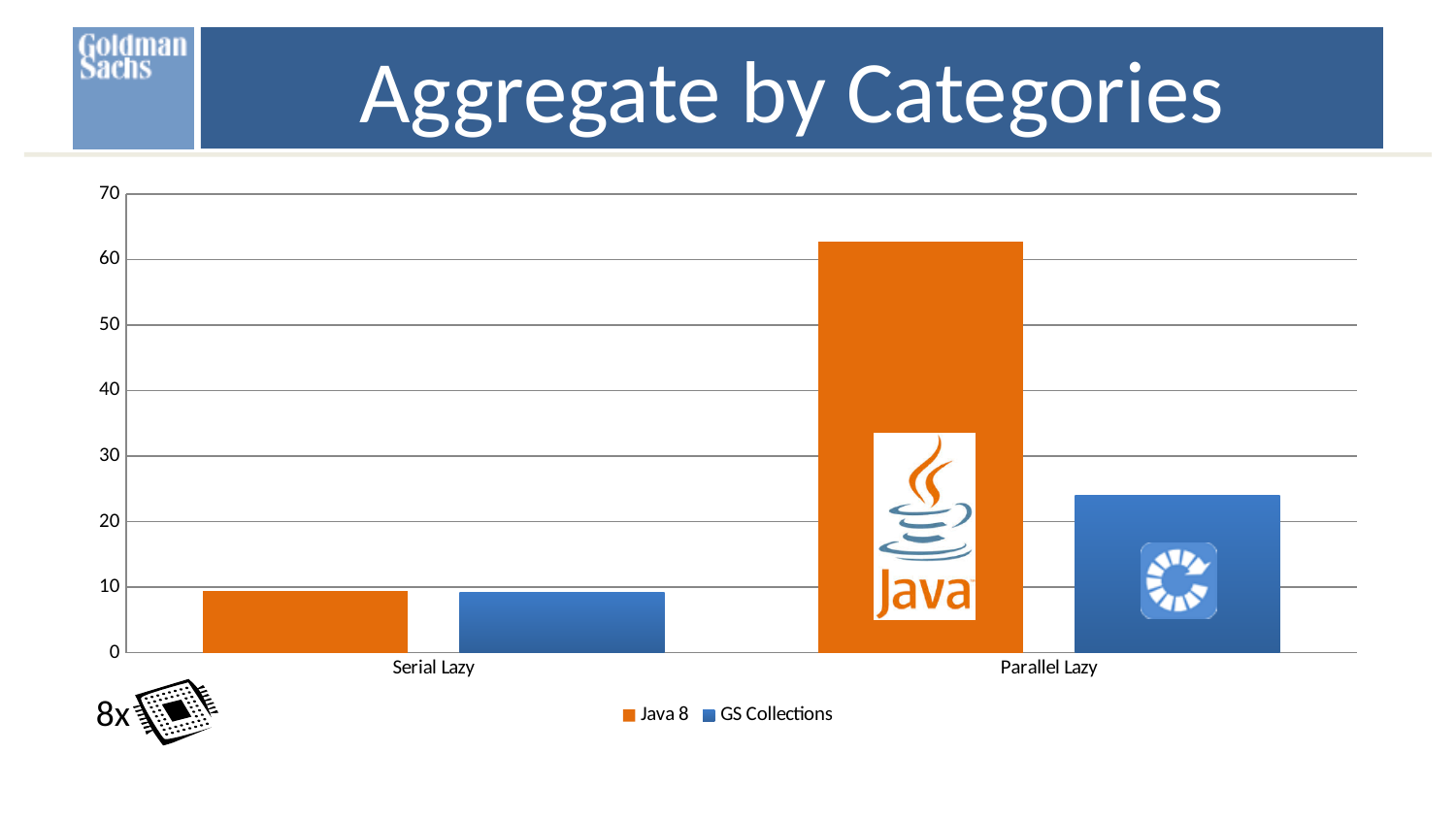
Which series is shown in orange? Java 8 Is the value for GS Collections in Parallel Lazy greater or less than 20? greater What is the title of the slide's chart? Aggregate by Categories What kind of chart is shown on the slide? bar chart Is the value for GS Collections in Parallel Lazy greater or less than 30? less Is the value for Java 8 in Serial Lazy greater or less than 20? less For Java 8, which category has the larger value: Serial Lazy or Parallel Lazy? Parallel Lazy For Parallel Lazy, which is larger: Java 8 or GS Collections? Java 8 How many categories are shown on the x axis? 2 How many series does the legend list? 2 Which bar is the highest in the chart? Java 8 for Parallel Lazy